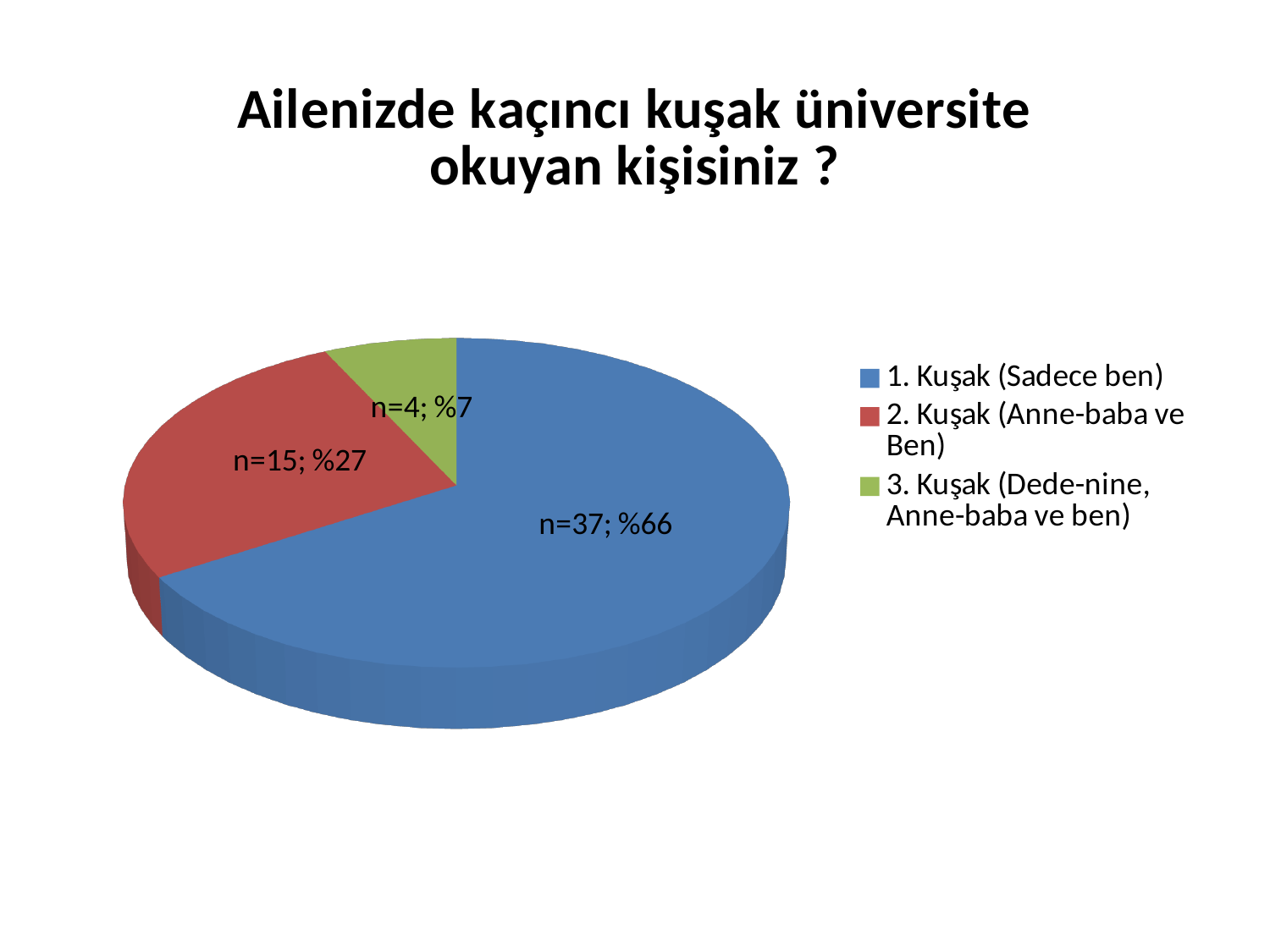
What is the title of the chart? Ailenizde kaçıncı kuşak üniversite okuyan kişisiniz ? What is the difference in count between '1. Kuşak (Sadece ben)' and '2. Kuşak (Anne-baba ve Ben)'? 22 How many entries does the legend list? 3 What is the count (n) for '3. Kuşak (Dede-nine, Anne-baba ve ben)'? n=4 Which category has the smallest slice? 3. Kuşak (Dede-nine, Anne-baba ve ben) What kind of chart is shown on the slide? pie chart Which is larger: the count for '2. Kuşak (Anne-baba ve Ben)' or '3. Kuşak (Dede-nine, Anne-baba ve ben)'? 2. Kuşak (Anne-baba ve Ben) How many slices does the pie chart have? 3 What colour is the slice for '3. Kuşak (Dede-nine, Anne-baba ve ben)'? green What percentage share does '2. Kuşak (Anne-baba ve Ben)' have? %27 Which category has the largest slice? 1. Kuşak (Sadece ben) What is the count (n) for '1. Kuşak (Sadece ben)'? n=37